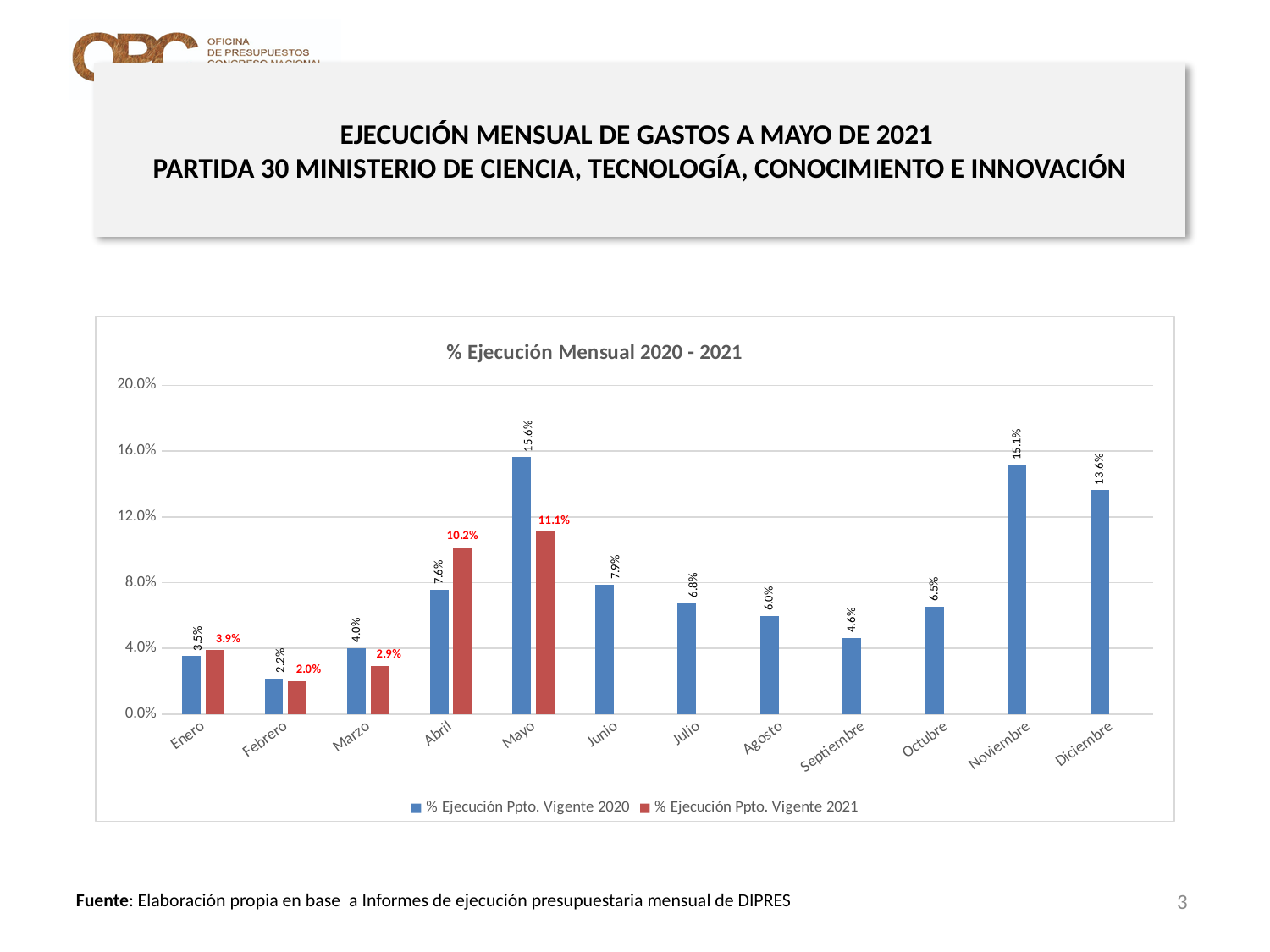
Which is larger for Mayo: the 2020 value or the 2021 value? 2020 value What is the difference between the 2021 and 2020 values for Abril? 2.6% How many months have a bar in the % Ejecución Ppto. Vigente 2021 series? 5 Is the value for Diciembre in the 2020 series greater or less than 12.0%? greater Which month has the highest value in the % Ejecución Ppto. Vigente 2020 series? Mayo What is the value for Noviembre in the % Ejecución Ppto. Vigente 2020 series? 15.1% What kind of chart is shown on the slide? Bar chart What is the value for Mayo in the % Ejecución Ppto. Vigente 2020 series? 15.6% Which month has the lowest value in the % Ejecución Ppto. Vigente 2021 series? Febrero What is the value for Abril in the % Ejecución Ppto. Vigente 2021 series? 10.2% How many series does the legend list? 2 What is the title of the chart? % Ejecución Mensual 2020 - 2021